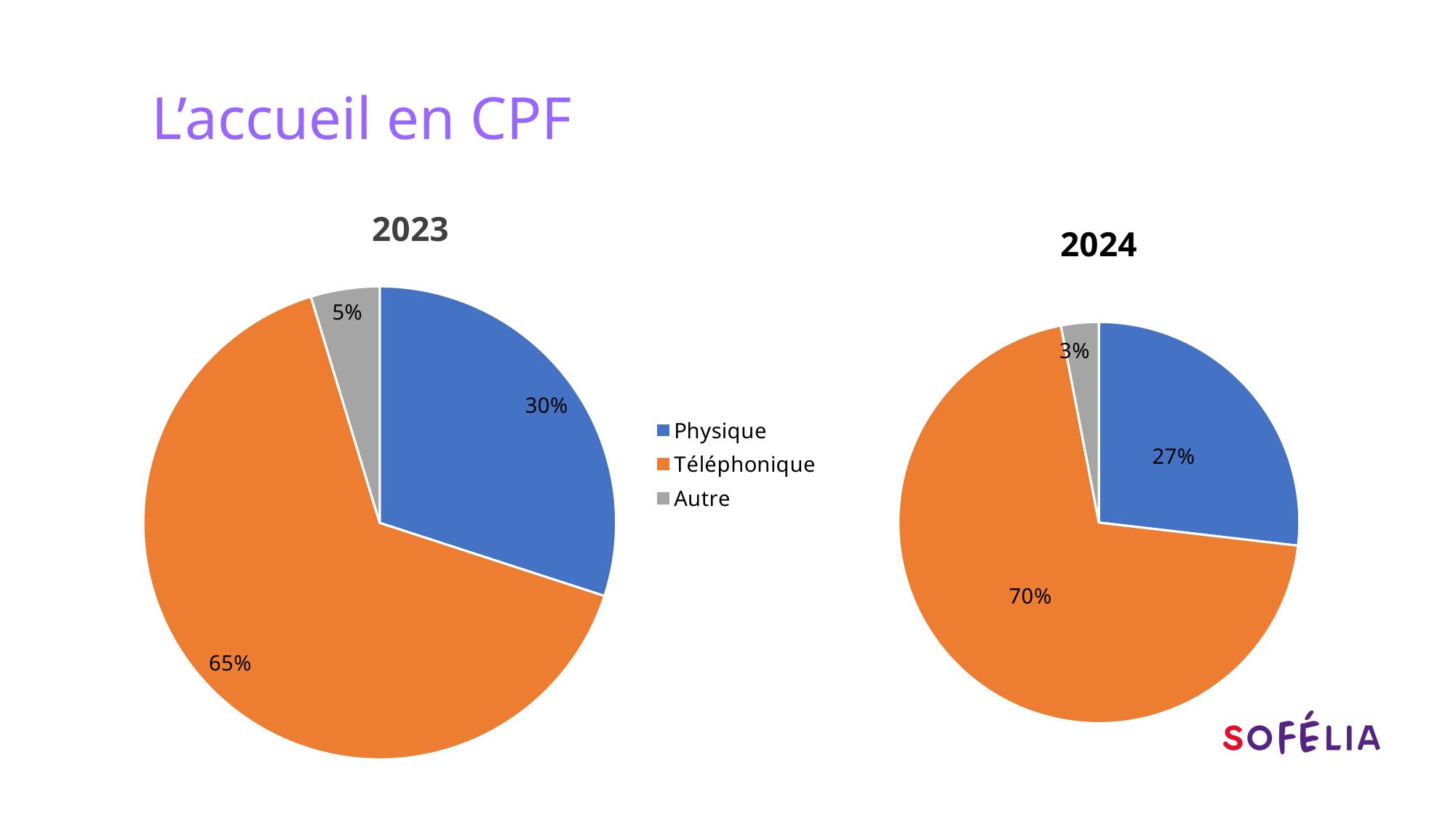
In the 2023 pie chart, which category has the largest slice? Téléphonique What kind of chart is the 2023 chart? Pie chart In the 2023 pie chart, what share does Physique have? 30% In the 2024 pie chart, which category has the smallest slice? Autre In the 2023 pie chart, what share does Téléphonique have? 65% Is the Physique share larger in the 2023 pie chart or the 2024 pie chart? 2023 In the 2024 pie chart, what share does Autre have? 3% How many categories does the legend list? 3 Which colour represents Téléphonique in the legend? Orange In the 2024 pie chart, what is the difference between the Téléphonique and Physique shares? 43% In the 2023 pie chart, what is the combined share of Physique and Autre? 35% In the 2024 pie chart, what share does Téléphonique have? 70%